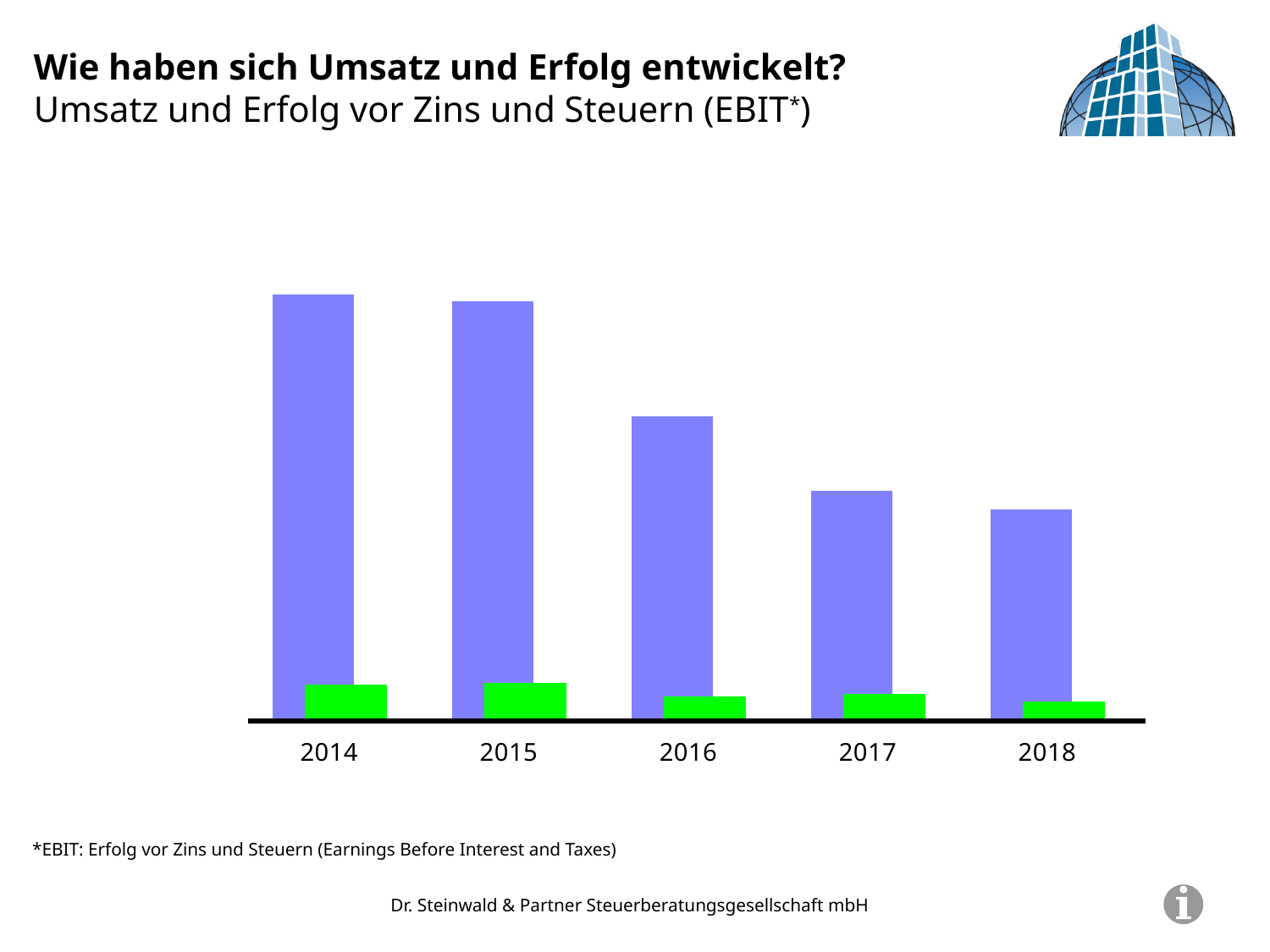
How many years are shown on the x axis of the chart? 5 Which year has the lowest green bar? 2018 Is the green bar for 2015 taller or shorter than the green bar for 2016? taller Do the blue bars generally rise or fall from 2014 to 2018? fall Is the blue bar for 2015 taller or shorter than the blue bar for 2018? taller Which year has the lowest blue bar? 2018 What kind of chart is shown on the slide? bar chart How many bar series (colours) are plotted in the chart? 2 Is the blue bar for 2016 taller or shorter than the blue bar for 2017? taller What is the first year shown on the x axis? 2014 What is the last year shown on the x axis? 2018